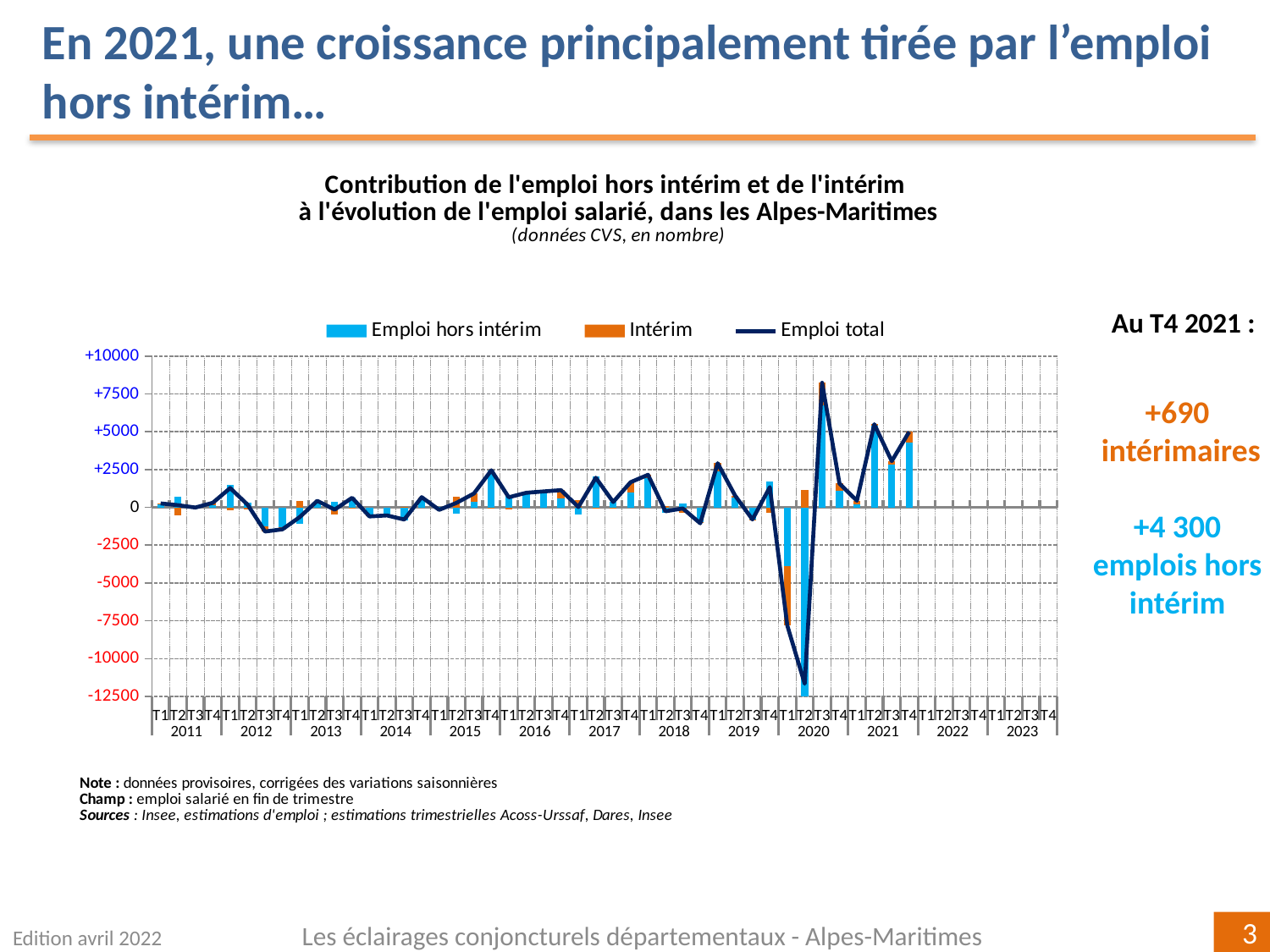
According to the annotation, what is the contribution of emploi hors intérim at T4 2021? +4 300 In which quarter does the Emploi total line reach its highest value? T3 2020 In which quarter does the Emploi total line reach its lowest value? T2 2020 Is the value of Emploi total at T3 2020 greater or less than 5000? greater What kind of chart is shown on the slide? A combined bar and line chart Which series are listed in the chart legend? Emploi hors intérim, Intérim, Emploi total At T4 2021, by how much does the Emploi hors intérim contribution exceed the Intérim contribution? 3 610 At T4 2021, which contribution is larger: Emploi hors intérim or Intérim? Emploi hors intérim What is the title of the chart? Contribution de l'emploi hors intérim et de l'intérim à l'évolution de l'emploi salarié, dans les Alpes-Maritimes How many series does the chart legend list? 3 Is the value of Emploi total at T2 2020 greater or less than -10000? less According to the annotation, what is the contribution of intérim at T4 2021? +690